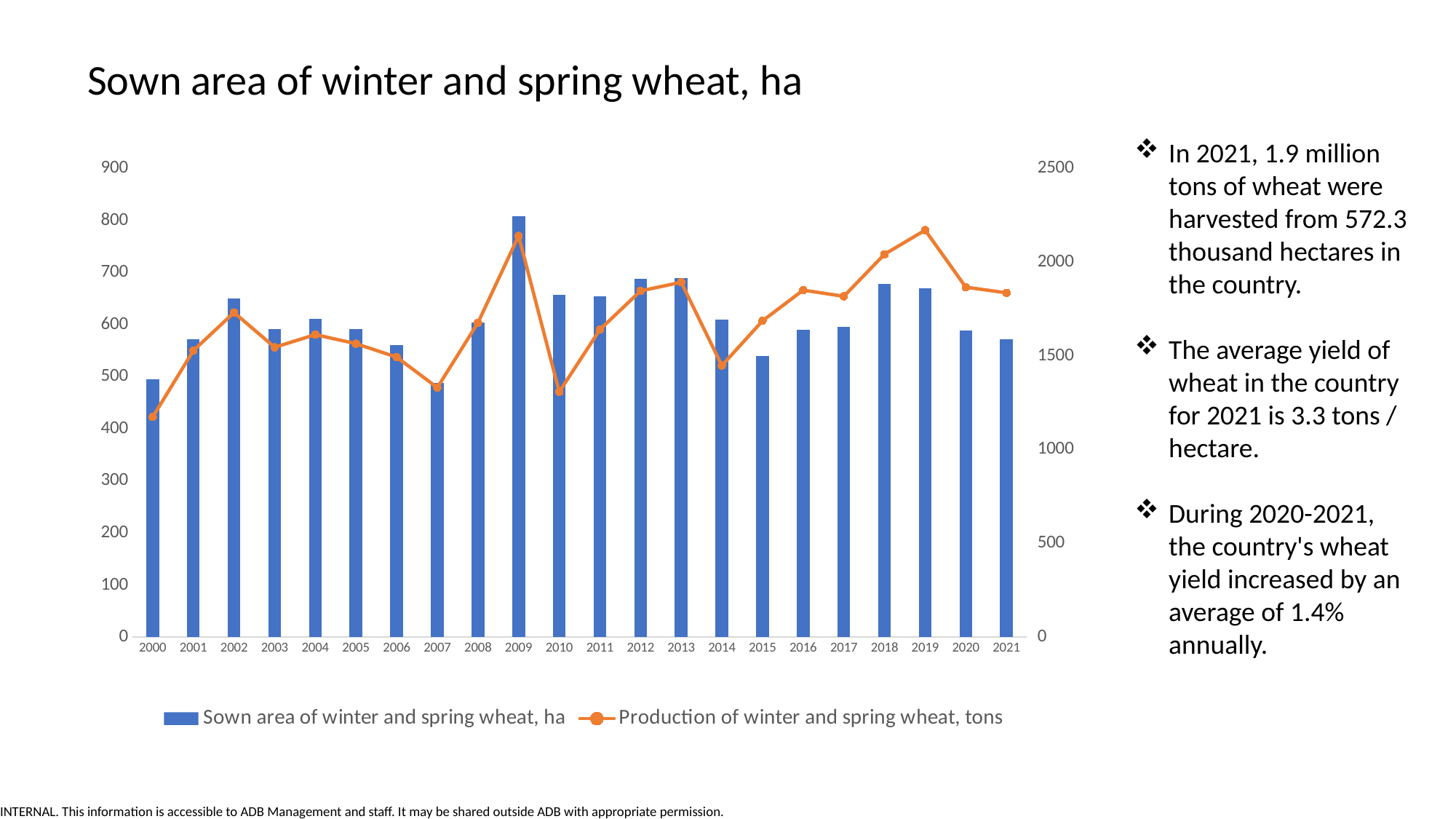
How many series does the chart's legend list? 2 What is the title of the chart? Sown area of winter and spring wheat, ha What kind of chart is shown on the slide? A combination bar and line chart Which year has the highest sown area of winter and spring wheat? 2009 Is the production of winter and spring wheat in 2000 greater or less than 1500? less Is the sown area of winter and spring wheat in 2009 greater or less than 700? greater Is the sown area of winter and spring wheat in 2015 greater or less than 600? less How many years are shown on the x axis of the chart? 22 Which year has the lowest sown area of winter and spring wheat? 2007 Which year has the lowest production of winter and spring wheat? 2000 Which year has a larger sown area of winter and spring wheat, 2009 or 2010? 2009